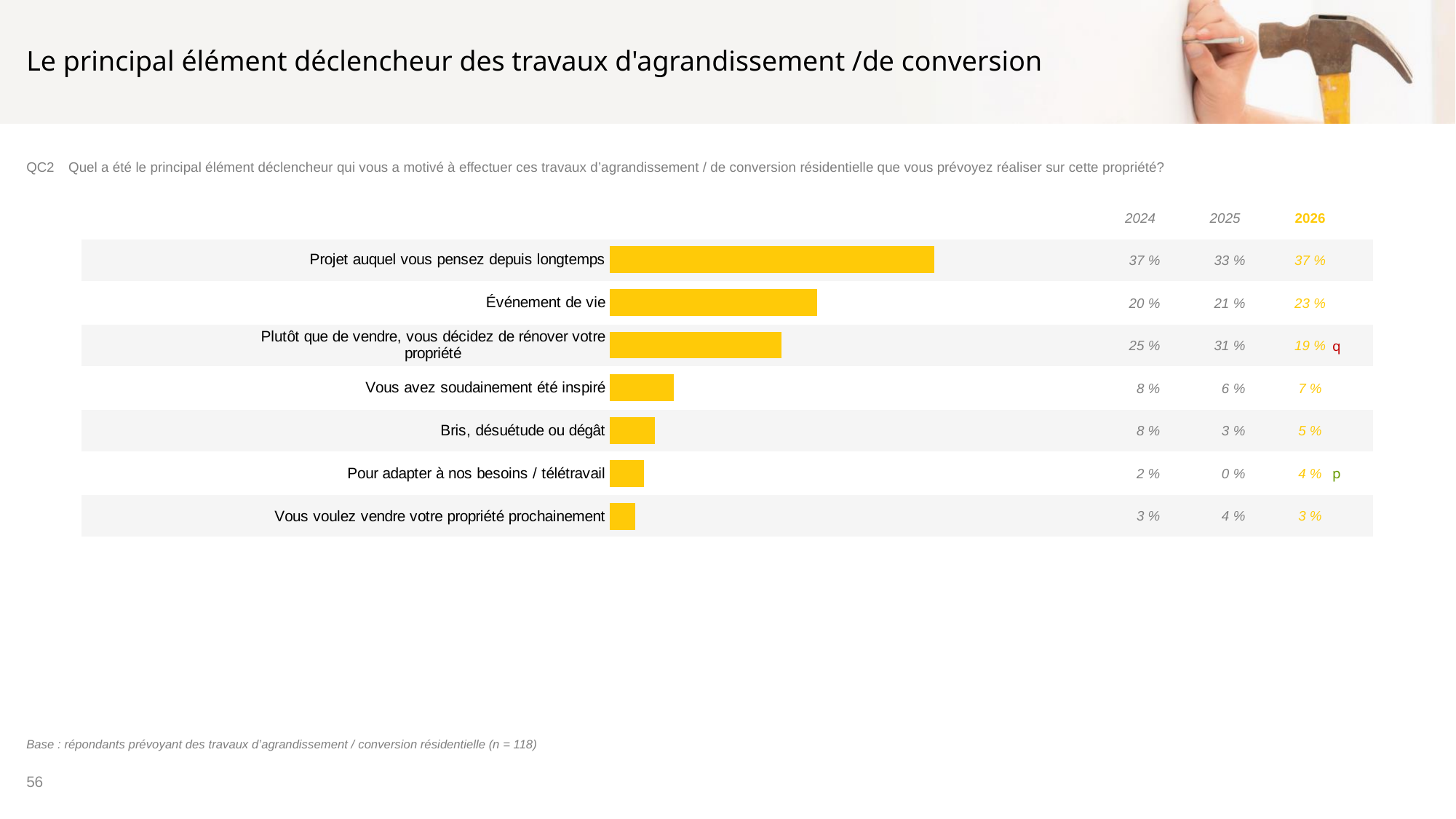
What is the 2026 value for "Événement de vie"? 23 % What kind of chart is shown on the slide? Bar chart Which is larger for 2026: "Événement de vie" or "Plutôt que de vendre, vous décidez de rénover votre propriété"? Événement de vie What is the 2025 value for "Plutôt que de vendre, vous décidez de rénover votre propriété"? 31 % What is the 2025 value for "Pour adapter à nos besoins / télétravail"? 0 % What is the 2024 value for "Bris, désuétude ou dégât"? 8 % What is the 2026 value for "Projet auquel vous pensez depuis longtemps"? 37 % Which category has the lowest 2026 value? Vous voulez vendre votre propriété prochainement How many years of data are shown in the table next to the chart? 3 Which category has the highest 2026 value? Projet auquel vous pensez depuis longtemps How many categories are shown in the chart? 7 What is the difference between the 2025 and 2026 values for "Plutôt que de vendre, vous décidez de rénover votre propriété"? 12 %